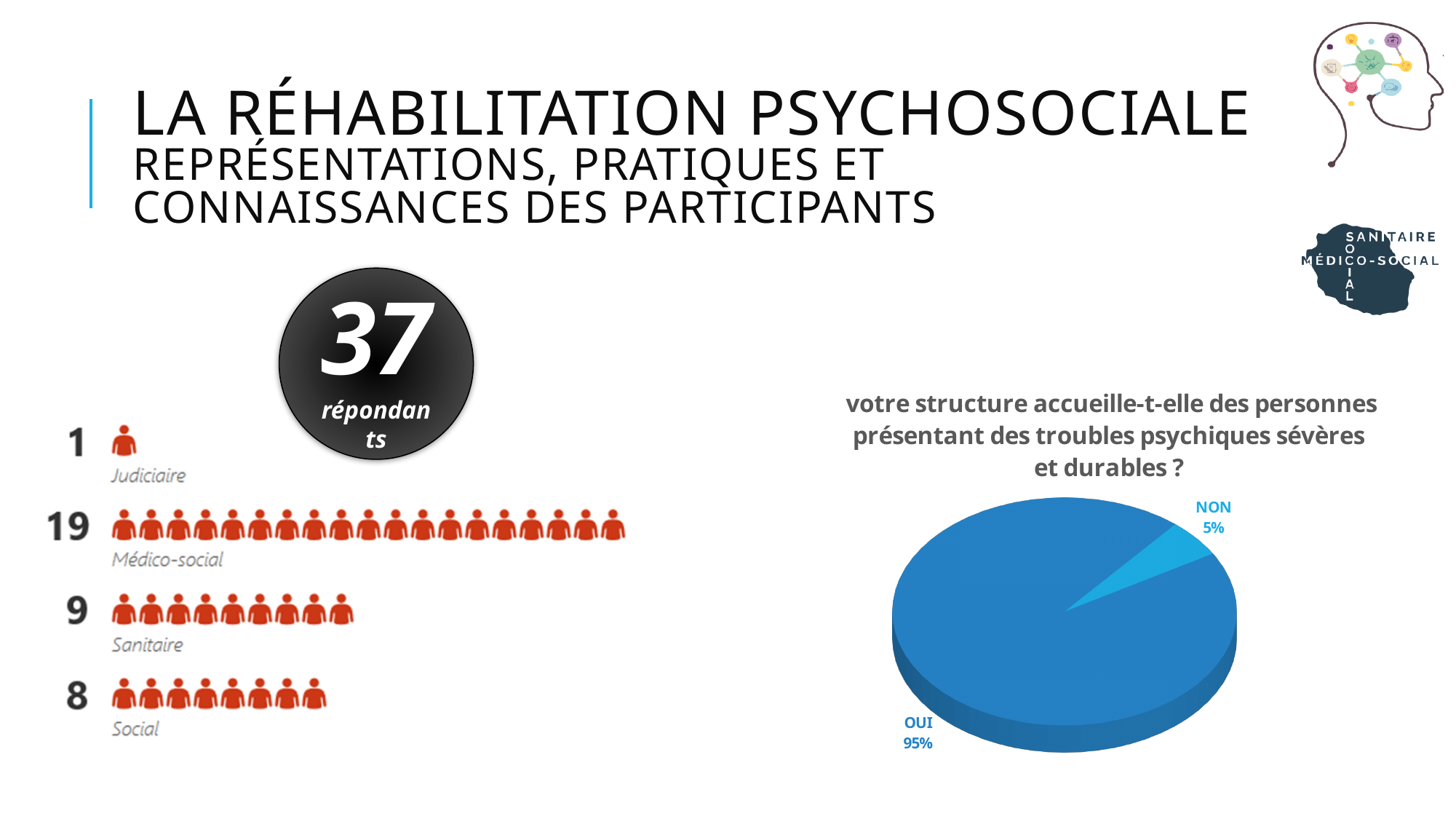
In the pie chart on the right, what share of respondents answered NON? 5% In the pie chart on the right, which answer has the larger slice, OUI or NON? OUI In the pictogram chart on the left, how many respondents are from the Sanitaire sector? 9 In the pictogram chart on the left, which sector has the most respondents? Médico-social In the pie chart on the right, how many slices are there? 2 In the pictogram chart on the left, what is the difference between the Médico-social and Social counts? 11 In the pictogram chart on the left, how many sectors are listed? 4 In the pictogram chart on the left, which sector has the fewest respondents? Judiciaire In the pie chart on the right, what is the difference in percentage points between OUI and NON? 90 In the pictogram chart on the left, how many respondents are from the Médico-social sector? 19 What kind of chart is shown on the right of the slide? Pie chart In the pie chart on the right, what share of respondents answered OUI? 95%